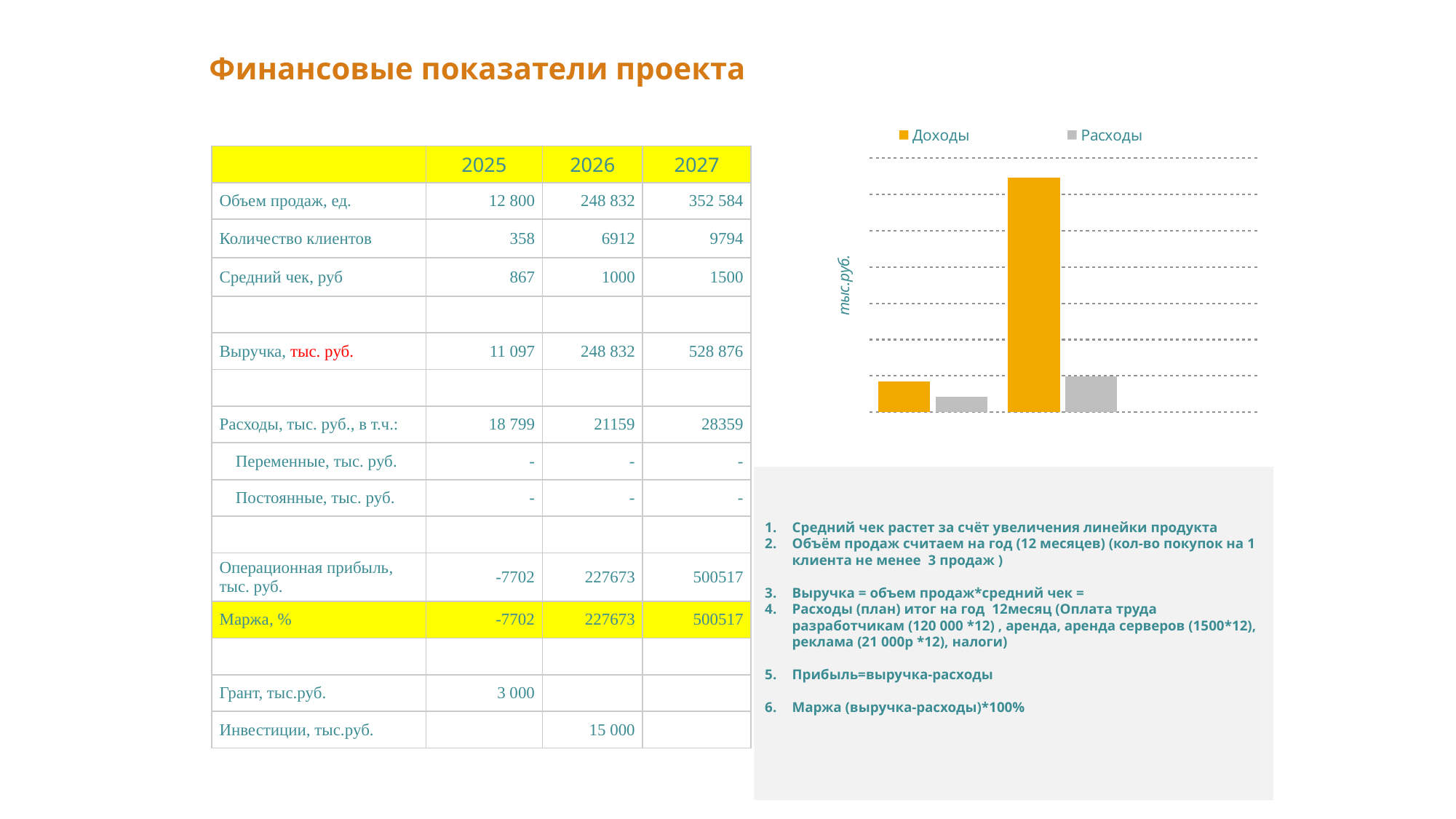
How many series does the chart's legend list? 2 Does the Расходы series rise or fall from the left group to the right group? rise Which bar is the tallest in the chart? Доходы in the right group What is the label on the chart's vertical axis? тыс.руб. In the right group of bars, which is larger: Доходы or Расходы? Доходы Which bar is the shortest in the chart? Расходы in the left group What are the two series named in the chart's legend? Доходы and Расходы How many groups of bars are plotted in the chart? 2 In the left group of bars, which is larger: Доходы or Расходы? Доходы What kind of chart is shown on the slide? bar chart Does the Доходы series rise or fall from the left group to the right group? rise